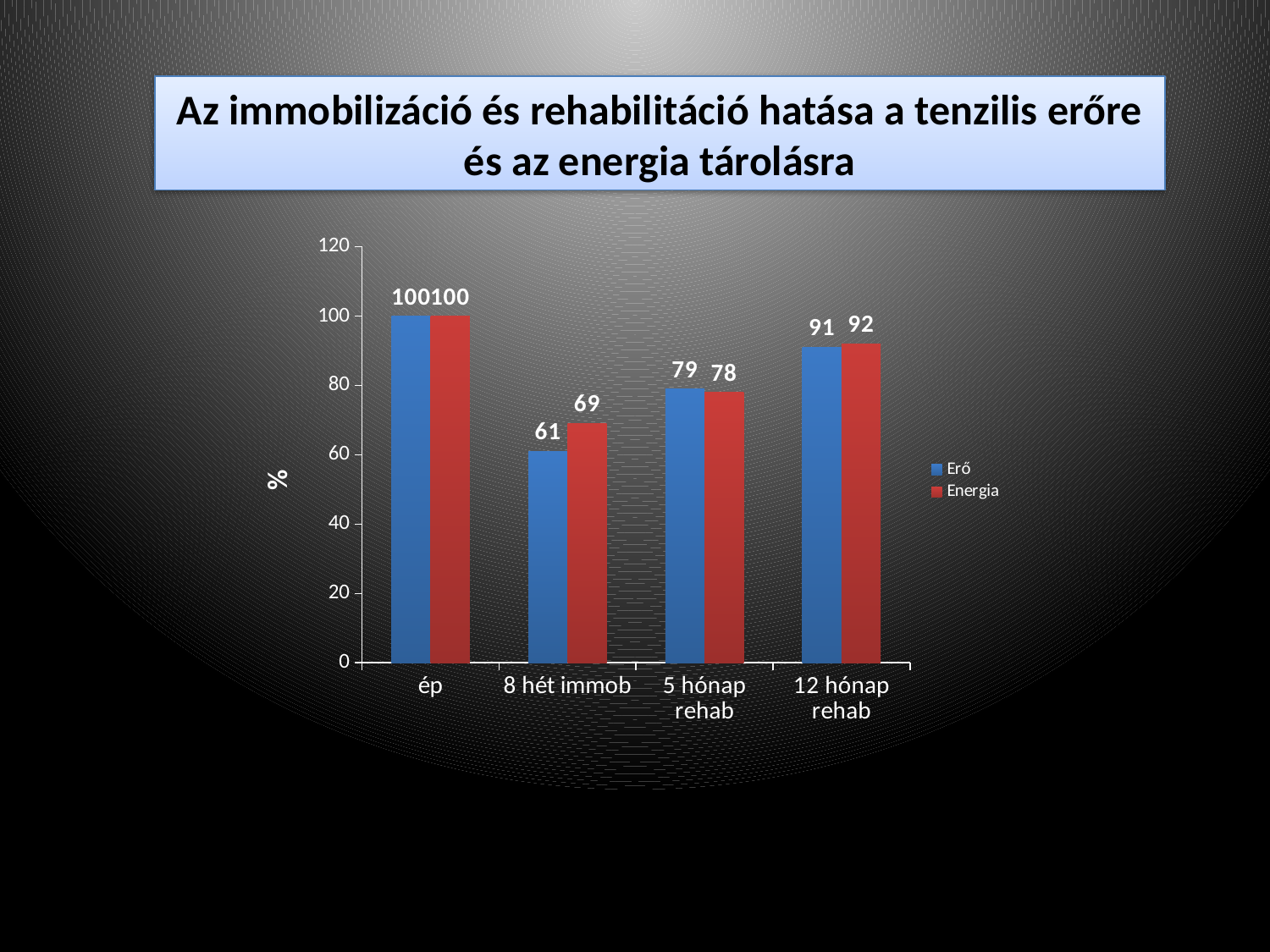
Which category has the highest Energia value? ép What is the difference between the Energia and Erő values for '8 hét immob'? 8 What kind of chart is shown on the slide? Bar chart Which is larger for '8 hét immob': the Erő value or the Energia value? Energia What is the Erő value for the '8 hét immob' category? 61 What is the Energia value for the '12 hónap rehab' category? 92 What is the label on the vertical axis? % What is the difference between the Erő values for 'ép' and '5 hónap rehab'? 21 Which category has the lowest Erő value? 8 hét immob How many categories are shown on the x axis? 4 What is the Energia value for the '5 hónap rehab' category? 78 How many series does the legend list? 2